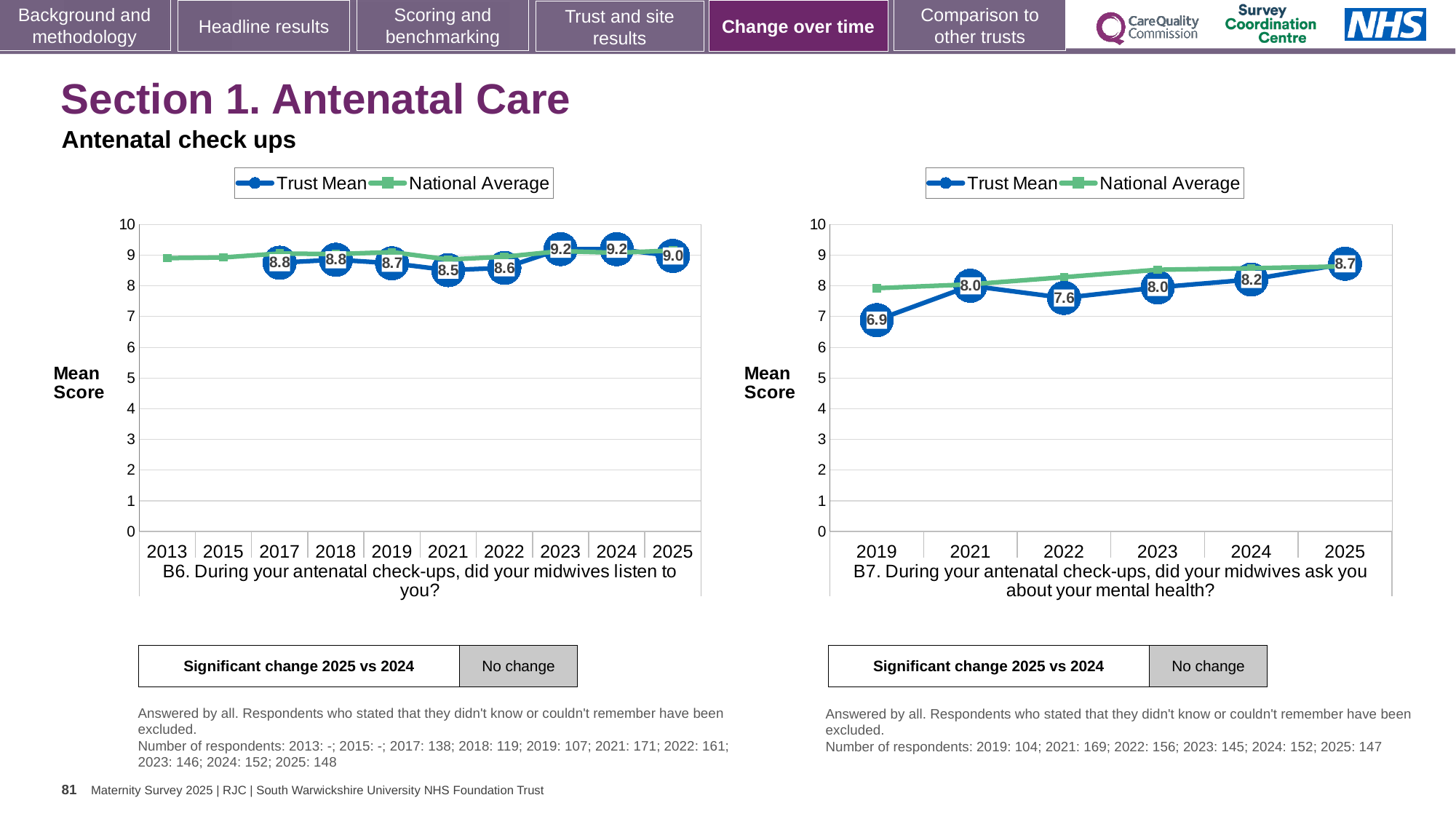
What kind of chart is the B7 chart (right)? Line chart In the B7 chart (right), is the National Average for 2019 greater or less than 7? greater In the B7 chart (right), does the Trust Mean rise or fall from 2023 to 2025? Rise In the B7 chart (right), which year has the highest Trust Mean? 2025 In the B7 chart (right), what is the Trust Mean for 2019? 6.9 How many series does the legend of the B7 chart (right) list? 2 How many years are shown on the x axis of the B6 chart (left)? 10 In the B7 chart (right), what is the difference between the Trust Mean in 2025 and in 2019? 1.8 In the B6 chart (left), which is larger, the Trust Mean for 2023 or for 2025? 2023 In the B6 chart (left), what is the Trust Mean for 2025? 9.0 In the B6 chart (left), which year has the lowest Trust Mean? 2021 What does the box below the B6 chart (left) say about significant change 2025 vs 2024? No change